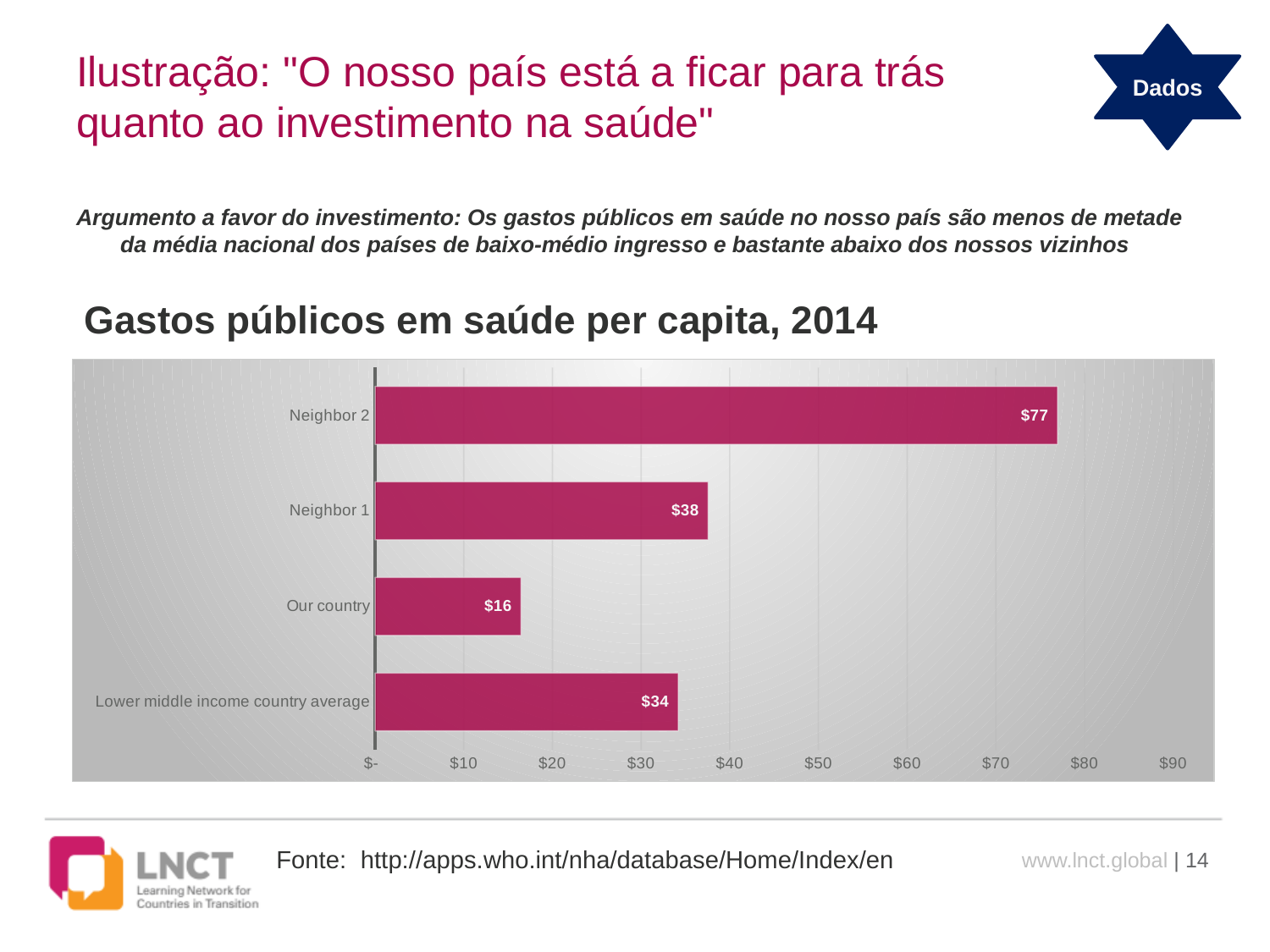
What is the public health expenditure per capita for Neighbor 2? $77 Which category has the lowest value? Our country What is the difference between Neighbor 2 and Our country? $61 What is the value shown for Our country? $16 What is the difference between Neighbor 1 and the Lower middle income country average? $4 What is the value for the Lower middle income country average? $34 What kind of chart is shown on the slide? Bar chart What is the title of the chart? Gastos públicos em saúde per capita, 2014 How many categories are shown in the chart? 4 Which category has the highest value? Neighbor 2 Which is larger, the value for Neighbor 1 or the value for Our country? Neighbor 1 What is the value shown for Neighbor 1? $38